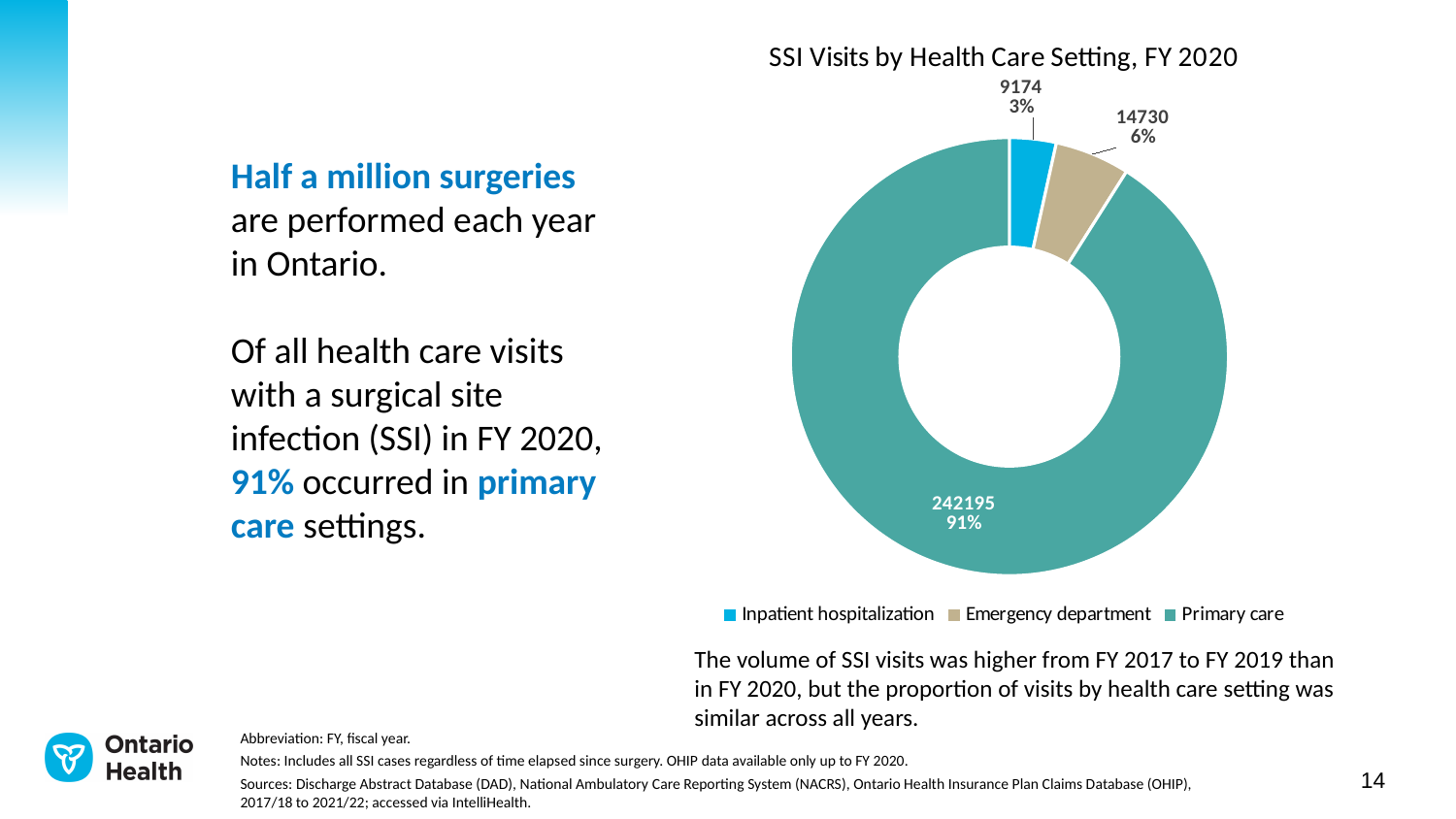
Which health care setting has the largest number of SSI visits? Primary care How many SSI visits occurred in inpatient hospitalization? 9174 What is the title of the chart? SSI Visits by Health Care Setting, FY 2020 How many SSI visits occurred in the emergency department? 14730 How many SSI visits occurred in primary care settings? 242195 What kind of chart is shown on the slide? Pie chart (doughnut) How many health care settings does the legend list? 3 Which health care setting has the smallest number of SSI visits? Inpatient hospitalization Which has more SSI visits: emergency department or inpatient hospitalization? Emergency department What share of SSI visits occurred in primary care? 91% What share of SSI visits occurred in the emergency department? 6% What is the difference in SSI visits between the emergency department and inpatient hospitalization? 5556